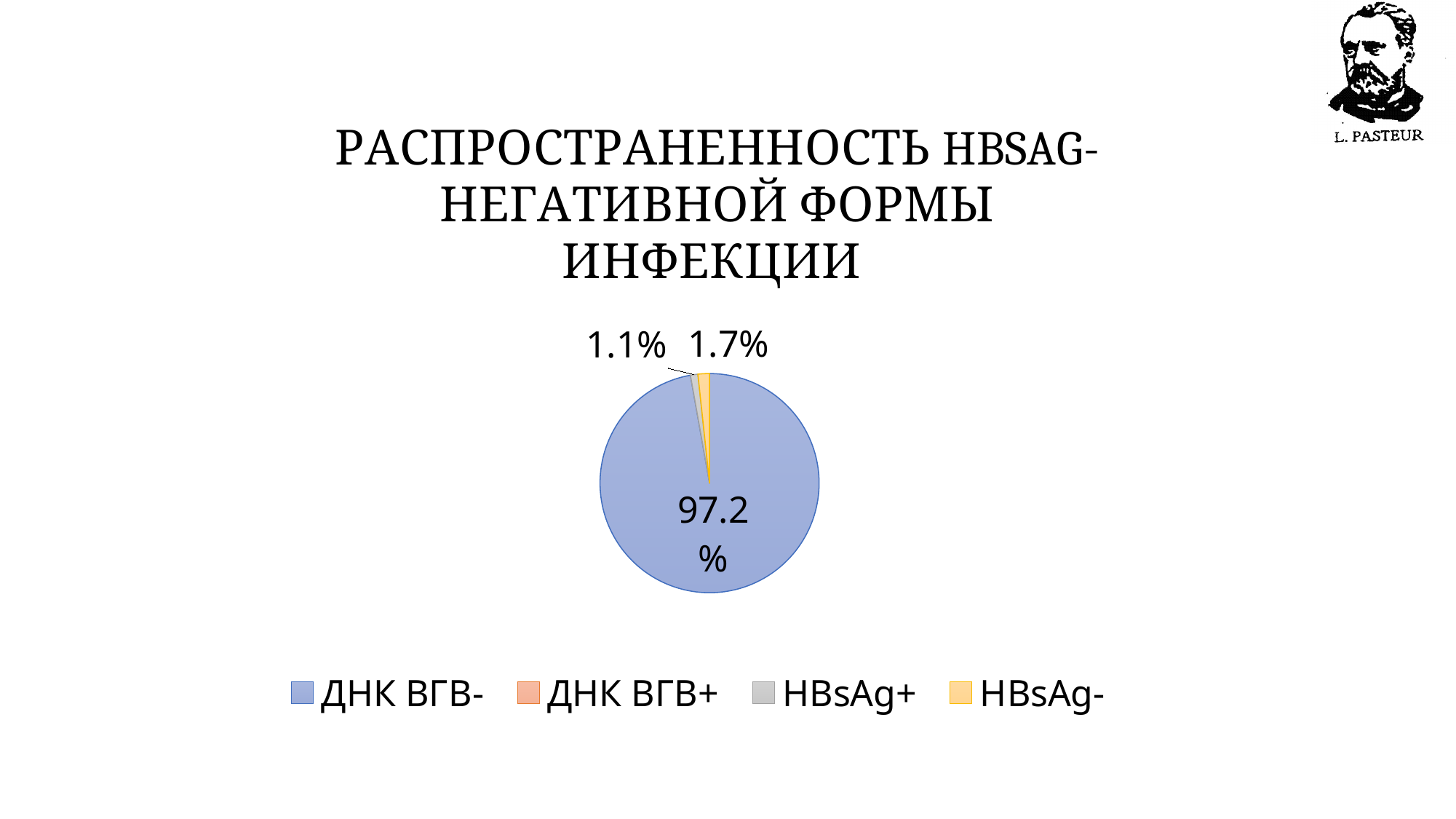
What share of the pie does ДНК ВГВ- have? 97.2% Is the share for ДНК ВГВ- greater or less than 90%? greater What share of the pie does HBsAg+ have? 1.1% Which is larger, the slice for HBsAg+ or the slice for HBsAg-? HBsAg- How many entries does the legend list? 4 What colour is the slice for ДНК ВГВ- in the pie chart? blue What is the title of the slide above the pie chart? РАСПРОСТРАНЕННОСТЬ HBSAG-НЕГАТИВНОЙ ФОРМЫ ИНФЕКЦИИ What is the difference between the ДНК ВГВ- share and the HBsAg- share? 95.5% What is the difference between the HBsAg- share and the HBsAg+ share? 0.6% Which category has the largest slice of the pie? ДНК ВГВ- What kind of chart is shown on the slide? pie chart What share of the pie does HBsAg- have? 1.7%